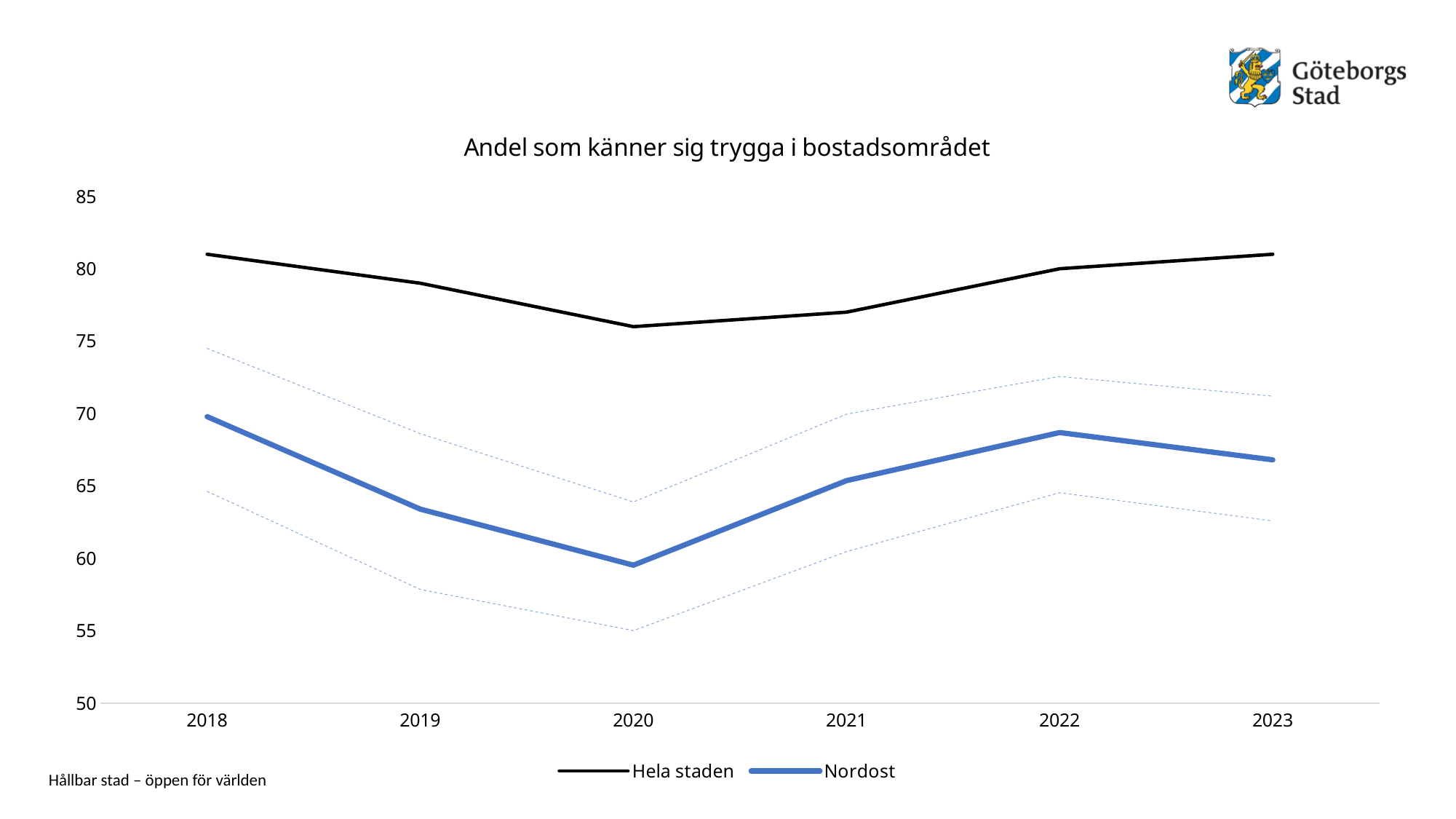
Is the value for Hela staden in 2021 greater or less than 80? less How many years are shown on the x axis? 6 What kind of chart is shown on the slide? line chart Is the value for Hela staden in 2018 greater or less than 80? greater In which year is the value for Nordost lowest? 2020 How many series does the legend list? 2 Does the value for Nordost rise or fall from 2018 to 2020? fall What is the title of the chart? Andel som känner sig trygga i bostadsområdet Which series has the larger value in 2020, Hela staden or Nordost? Hela staden Is the value for Nordost in 2022 greater or less than 65? greater In which year is the value for Hela staden lowest? 2020